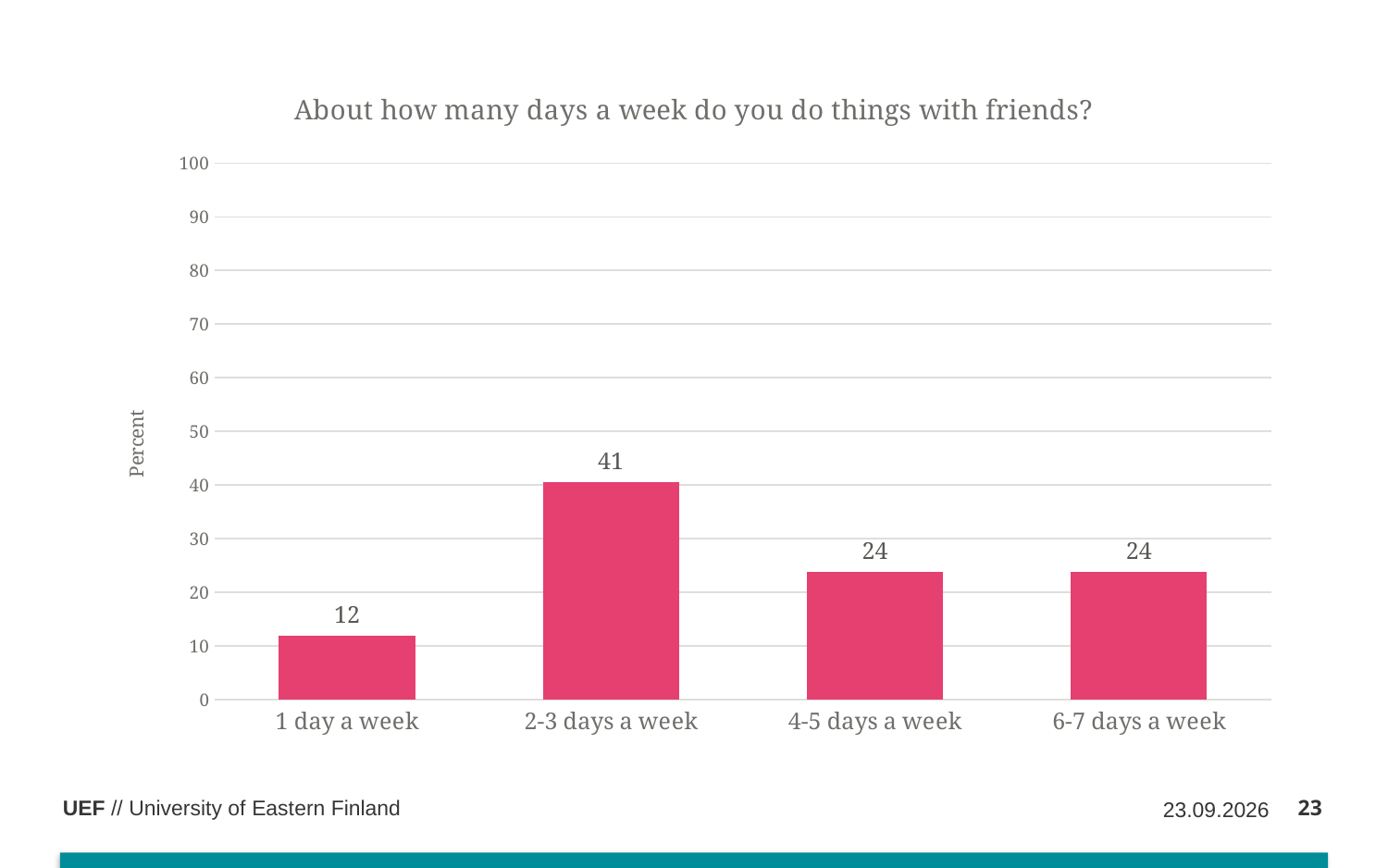
What kind of chart is shown on the slide? bar chart What is the value for '2-3 days a week'? 41 What is the difference between the values for '2-3 days a week' and '6-7 days a week'? 17 What is the value for '4-5 days a week'? 24 What is the difference between the values for '2-3 days a week' and '1 day a week'? 29 Which is larger, the value for '2-3 days a week' or the value for '4-5 days a week'? 2-3 days a week Which category has the highest value? 2-3 days a week What is the value for '1 day a week'? 12 Which category has the lowest value? 1 day a week Is the value for '2-3 days a week' greater or less than 30? greater What is the title of the chart? About how many days a week do you do things with friends? How many categories are shown on the x axis? 4